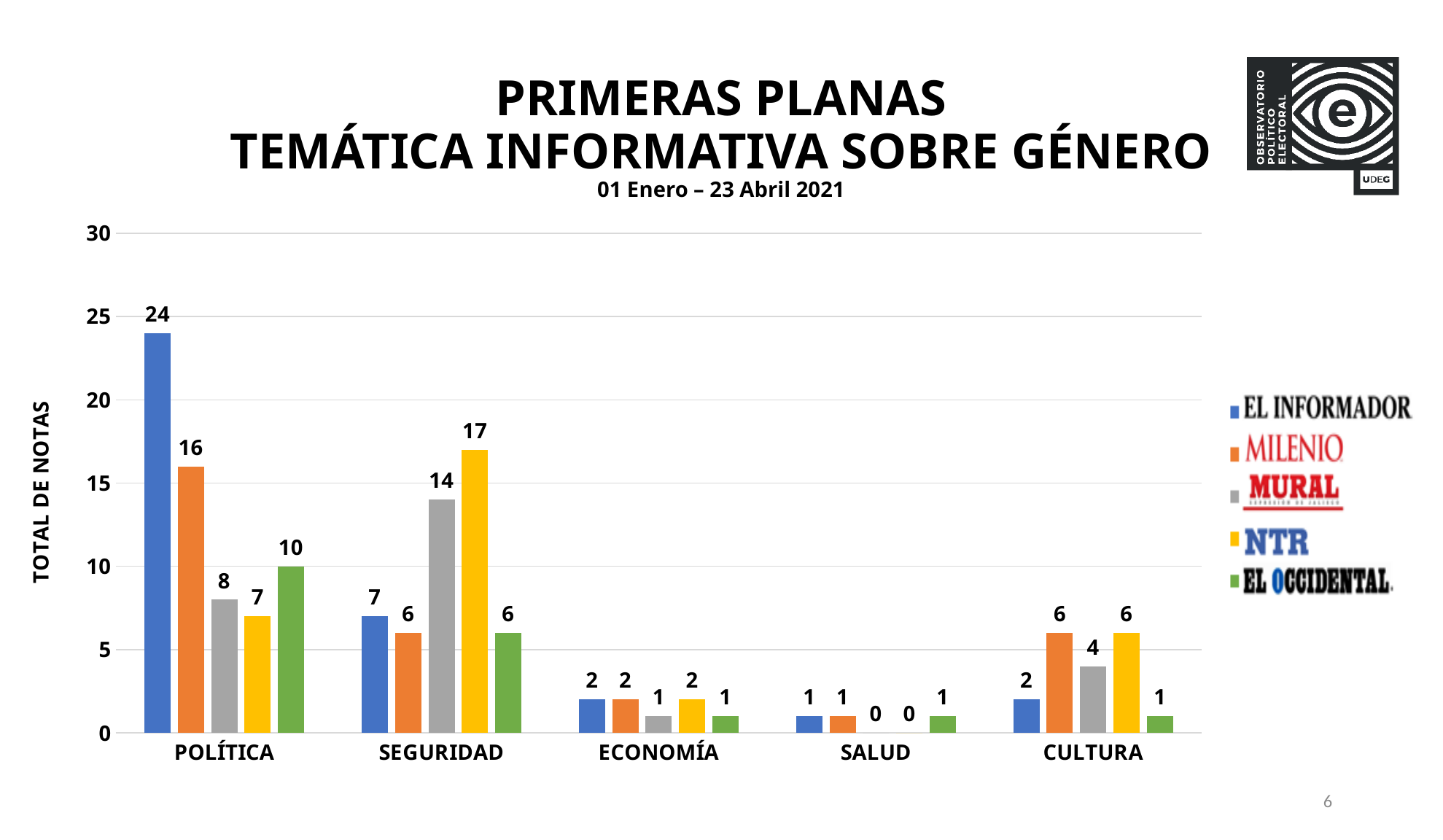
What is the label of the vertical axis? TOTAL DE NOTAS What is the difference between EL INFORMADOR and MILENIO in the POLÍTICA category? 8 What is the value for NTR in the SEGURIDAD category? 17 Is the value for EL INFORMADOR in POLÍTICA greater or less than 20? greater Which is larger in the SEGURIDAD category: MURAL or EL OCCIDENTAL? MURAL Which series has the lowest value in the POLÍTICA category? NTR What kind of chart is shown on the slide? bar chart How many categories are shown on the x axis? 5 What is the value for EL INFORMADOR in the POLÍTICA category? 24 How many series does the legend list? 5 What is the value for MURAL in the CULTURA category? 4 Which series has the highest value in the SEGURIDAD category? NTR